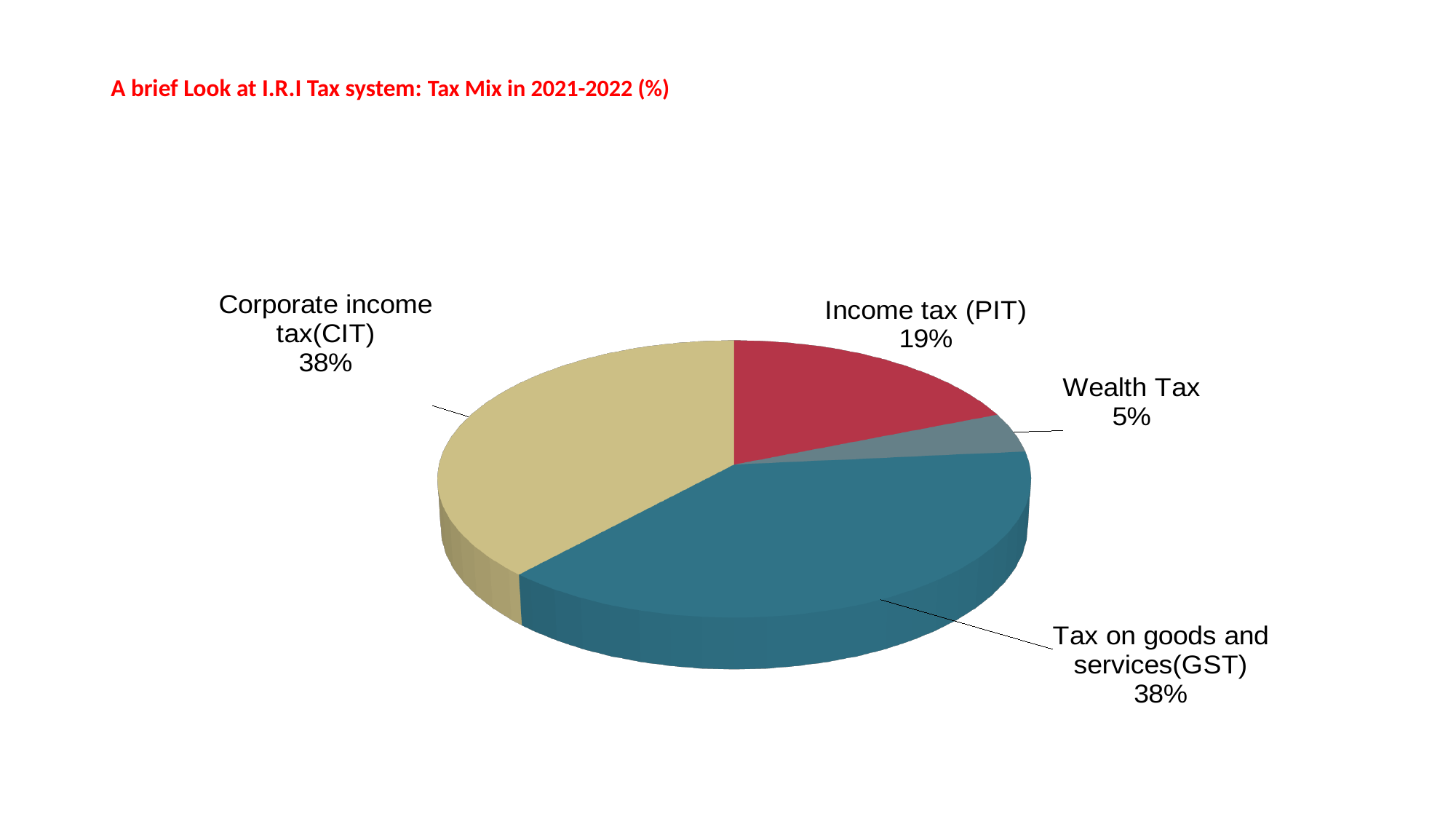
What share of the pie does Wealth Tax represent? 5% What share of the pie does Tax on goods and services (GST) represent? 38% What kind of chart is shown on the slide? pie chart What is the title of the slide? A brief Look at I.R.I Tax system: Tax Mix in 2021-2022 (%) Which is larger, the share for Tax on goods and services (GST) or the share for Income tax (PIT)? Tax on goods and services (GST) Which category has the smallest slice of the pie? Wealth Tax How many slices does the pie chart have? 4 What is the difference in percentage points between Income tax (PIT) and Wealth Tax? 14 What is the difference in percentage points between Corporate income tax (CIT) and Income tax (PIT)? 19 What share of the pie does Income tax (PIT) represent? 19% Which is larger, the share for Income tax (PIT) or the share for Wealth Tax? Income tax (PIT)